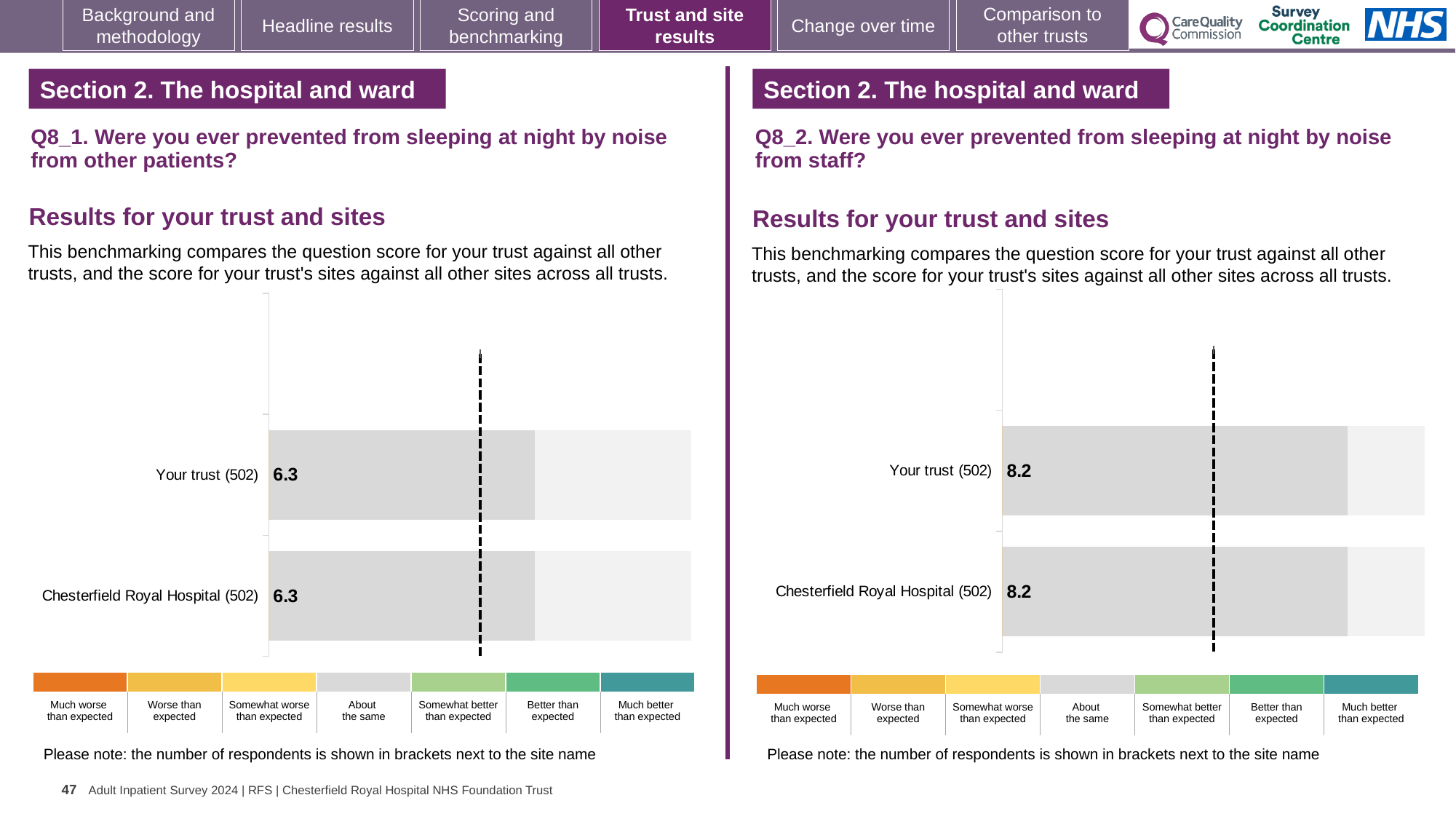
How many respondents are shown in brackets next to Chesterfield Royal Hospital in the right chart (Q8_2)? 502 How many benchmark categories are shown in the colour key below the left chart (Q8_1)? 7 In the left chart (Q8_1, noise from other patients), what is the score for Your trust? 6.3 In the left chart (Q8_1, noise from other patients), what is the score for Chesterfield Royal Hospital? 6.3 In the left chart (Q8_1), what is the difference between the score for Your trust and the score for Chesterfield Royal Hospital? 0 How many bars are plotted in the right chart (Q8_2)? 2 How many bars are plotted in the left chart (Q8_1)? 2 What is the difference between the Your trust score in the right chart (Q8_2) and the Your trust score in the left chart (Q8_1)? 1.9 What kind of chart is used in the left chart (Q8_1)? Bar chart Is the score for Your trust in the right chart (Q8_2) larger or smaller than the score for Your trust in the left chart (Q8_1)? larger In the right chart (Q8_2, noise from staff), what is the score for Chesterfield Royal Hospital? 8.2 In the right chart (Q8_2, noise from staff), what is the score for Your trust? 8.2